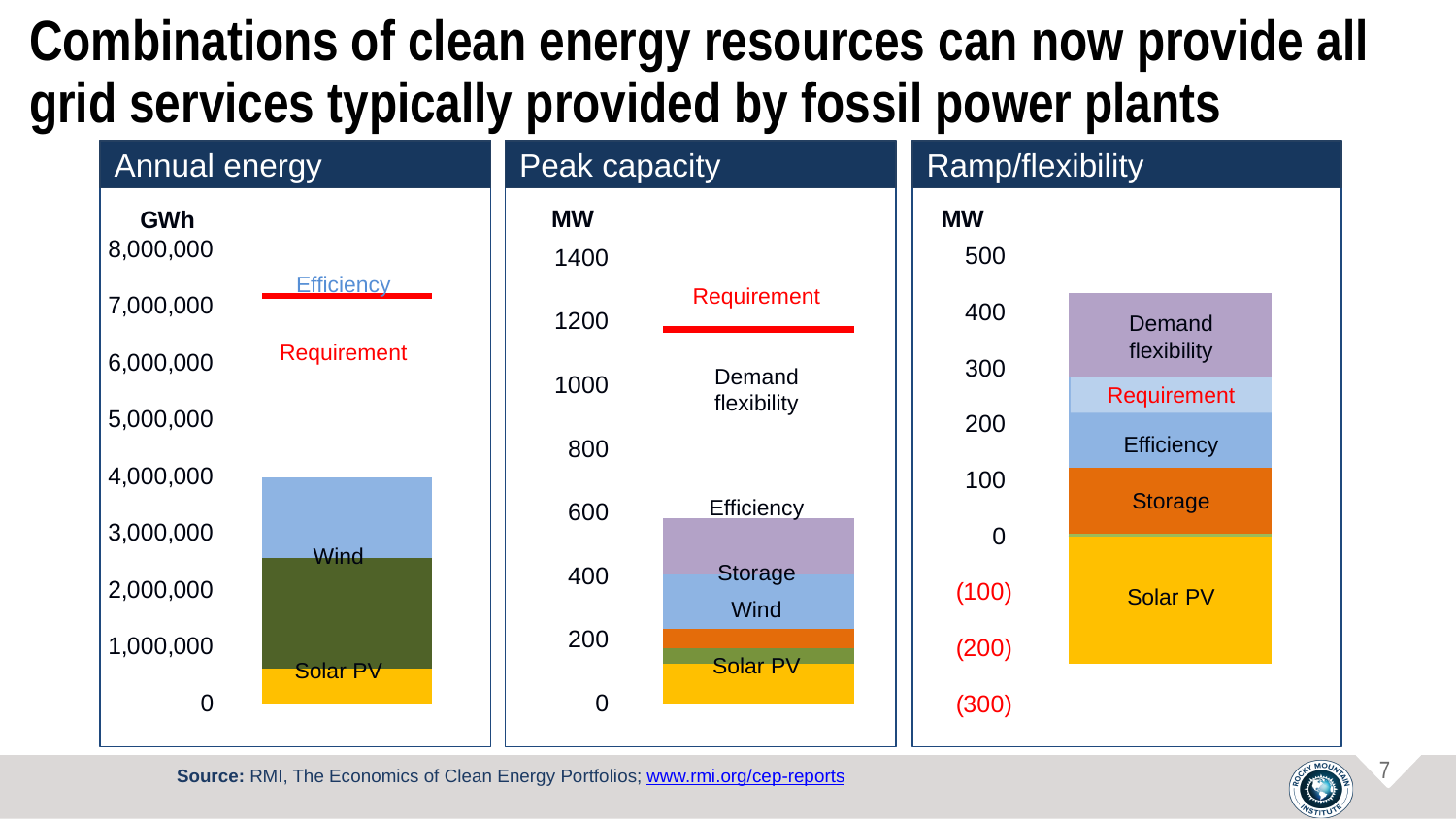
In the Annual energy chart, is the Requirement line greater or less than 6,000,000? greater In the Annual energy chart, is the top of the stacked bar greater or less than 5,000,000? less What unit is shown on the y axis of the Annual energy chart? GWh How many charts are shown on the slide? 3 In the Ramp/flexibility chart, is the Solar PV value greater or less than 0? less In the Ramp/flexibility chart, which segment extends below 0? Solar PV In the Annual energy chart, which is larger, the Requirement line or the top of the stacked bar? Requirement What unit is shown on the y axis of the Peak capacity chart? MW In the Ramp/flexibility chart, how many labeled segments make up the stacked bar? 5 What type of chart is the Annual energy chart? Stacked bar chart